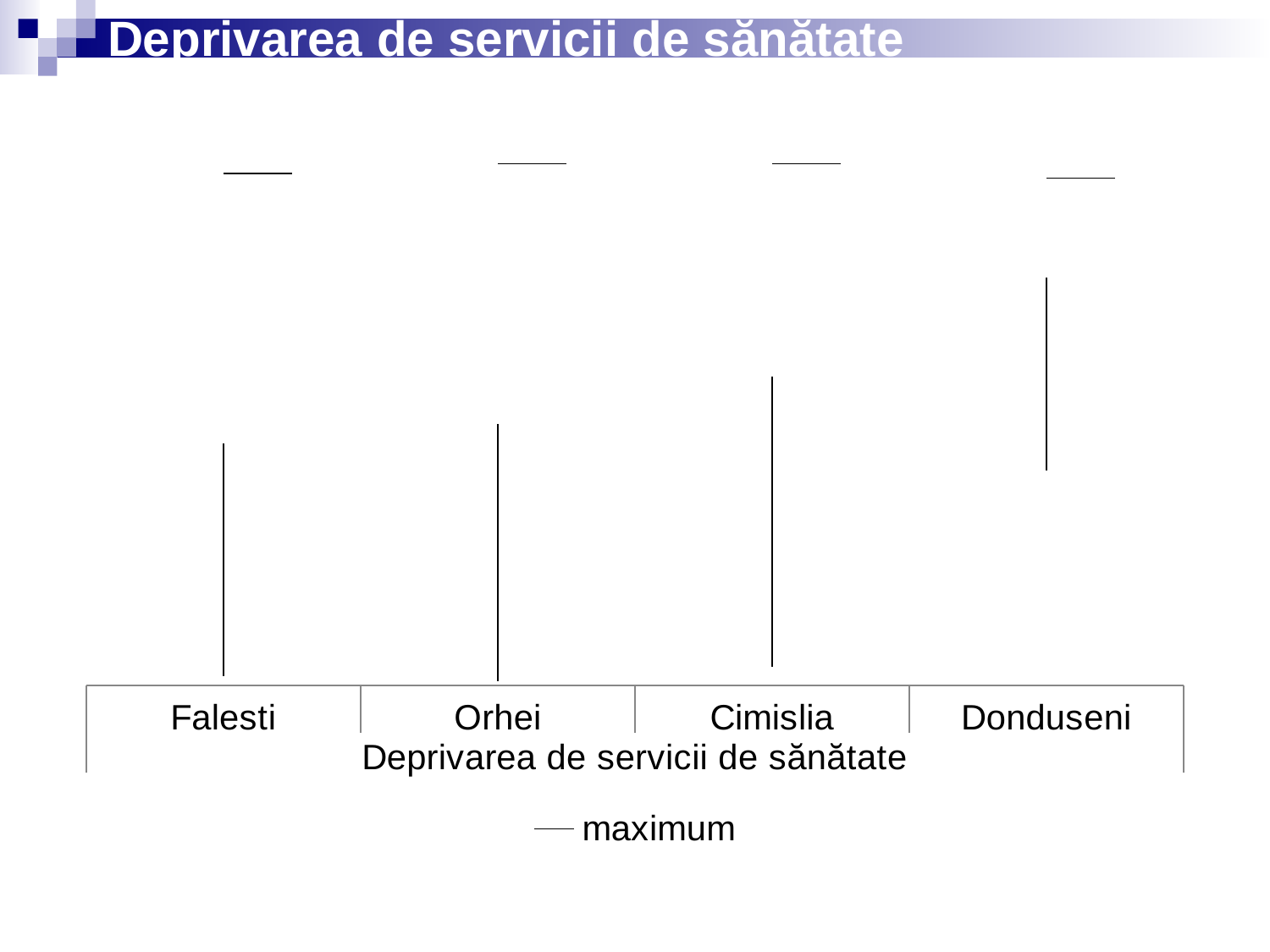
Which category's vertical line is the shortest in the chart? Donduseni How many series does the chart's legend list? 1 What is the legend entry shown below the chart? maximum What is the title of the chart? Deprivarea de servicii de sănătate How many categories are shown on the x axis of the chart? 4 Which category is listed first on the x axis of the chart? Falesti Which category is listed last on the x axis of the chart? Donduseni